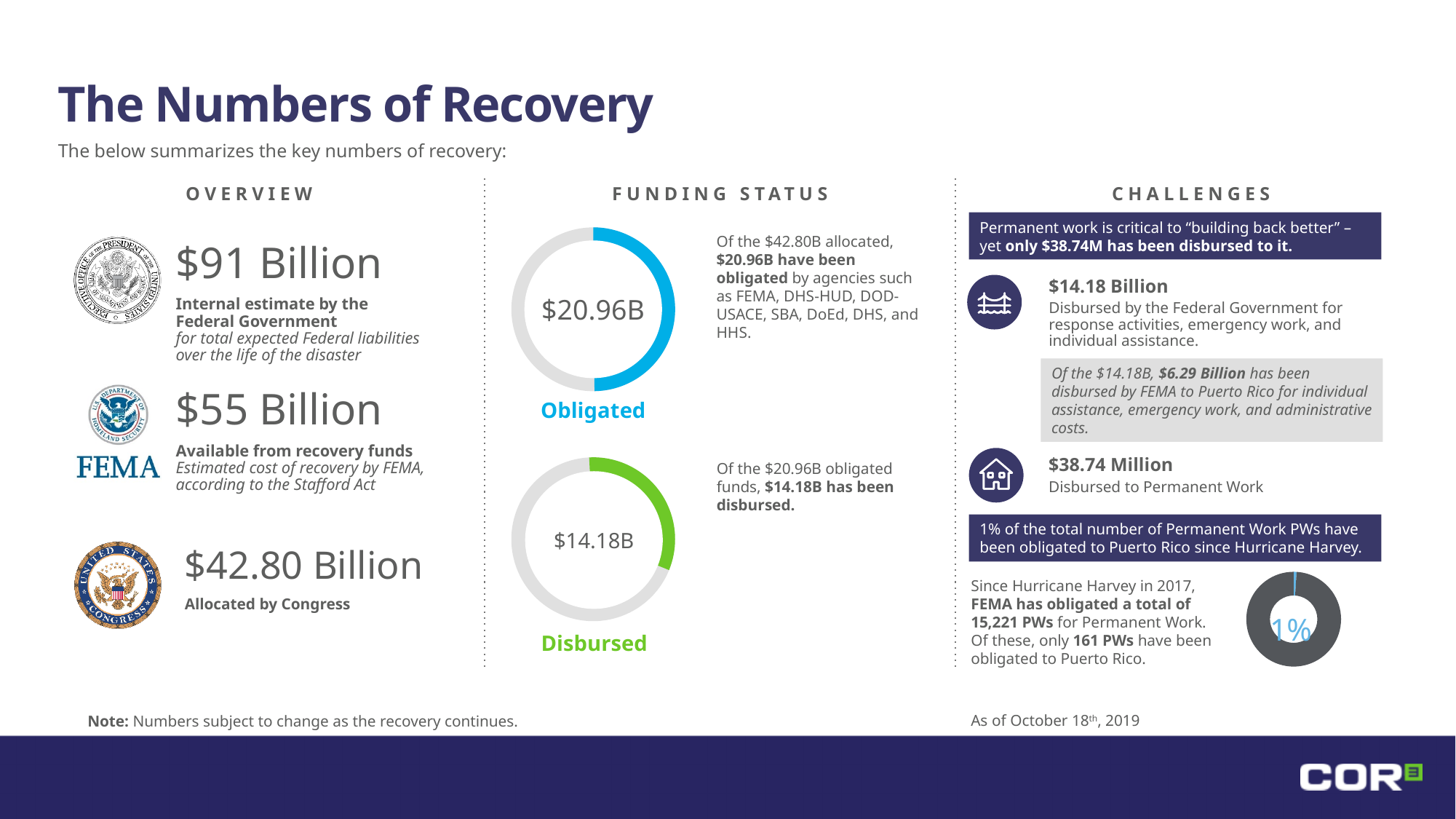
What colour is the filled portion of the "Obligated" donut chart? Blue How many donut charts are shown on the slide? 3 What kind of chart is the "Obligated" chart in the Funding Status section? Donut (pie) chart What is the difference between the value in the "Obligated" donut chart and the value in the "Disbursed" donut chart? $6.78B In the "Obligated" donut chart, what value is shown in the center? $20.96B In the "Disbursed" donut chart, what value is shown in the center? $14.18B Which donut chart shows the larger value, "Obligated" or "Disbursed"? Obligated In the small donut chart in the Challenges section, what share is highlighted? 1% What colour is the filled portion of the "Disbursed" donut chart? Green